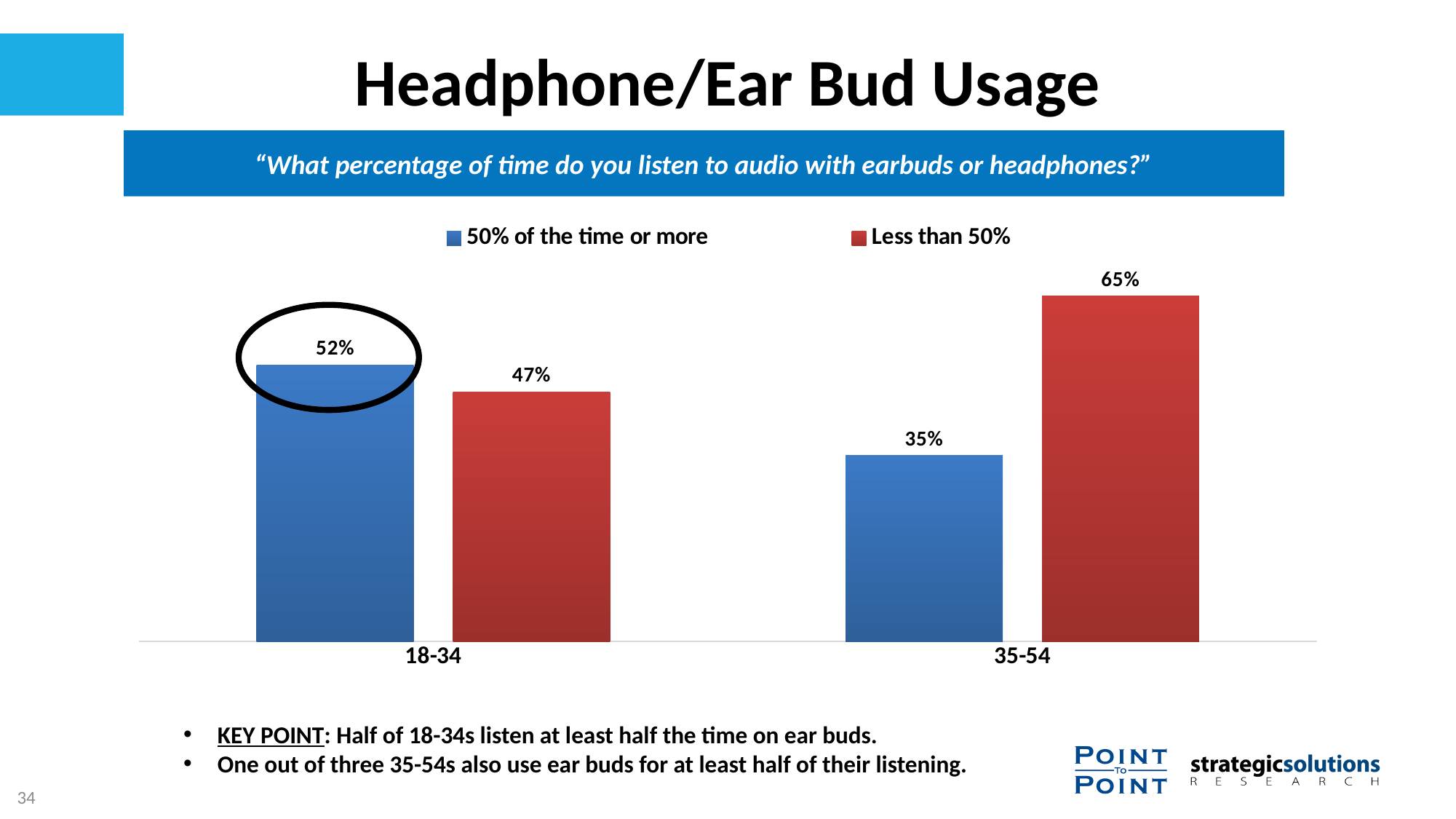
Which bar on the chart has the highest value? Less than 50%, 35-54 Which age group has the higher value for '50% of the time or more'? 18-34 What is the difference between the 'Less than 50%' and '50% of the time or more' values for the 35-54 age group? 30% What is the value for 'Less than 50%' in the 18-34 age group? 47% What kind of chart is shown on the slide? Bar chart What is the value for '50% of the time or more' in the 35-54 age group? 35% What percentage of 18-34s listen with earbuds or headphones 50% of the time or more? 52% What percentage of 35-54s listen with earbuds or headphones less than 50% of the time? 65% How many age groups are shown on the x axis? 2 What is the difference between the '50% of the time or more' values for 18-34 and 35-54? 17% Which bar on the chart has the lowest value? 50% of the time or more, 35-54 How many series does the legend list? 2